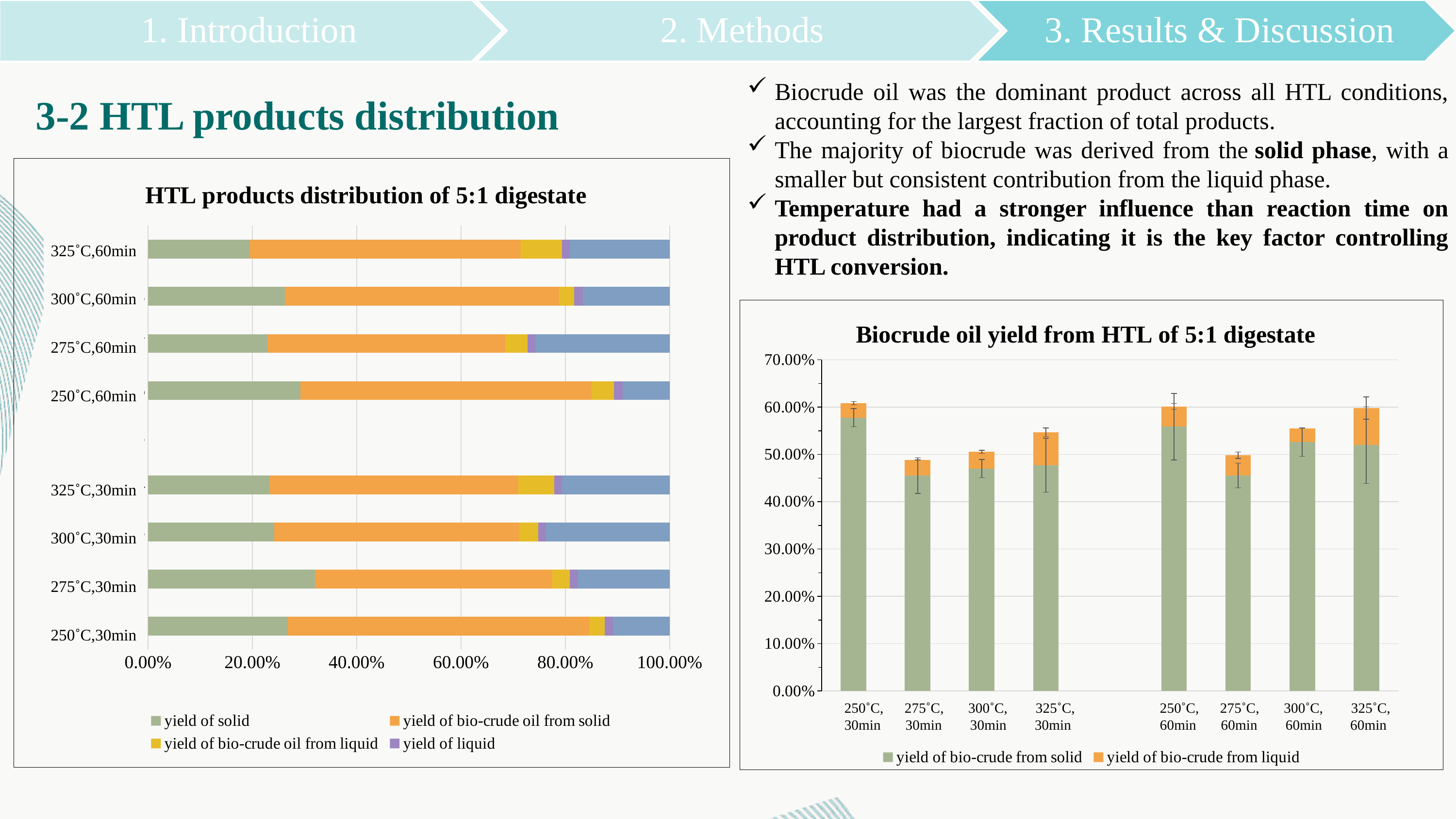
In the 'HTL products distribution of 5:1 digestate' chart, which series is shown in orange? yield of bio-crude oil from solid In the 'Biocrude oil yield from HTL of 5:1 digestate' chart, is the total biocrude yield for 325˚C, 30min greater or less than 50.00%? greater In the 'Biocrude oil yield from HTL of 5:1 digestate' chart, is the total biocrude yield for 275˚C, 30min greater or less than 50.00%? less How many condition categories are plotted in the 'Biocrude oil yield from HTL of 5:1 digestate' chart? 8 In the 'HTL products distribution of 5:1 digestate' chart, which has the larger yield of solid: 275˚C,30min or 325˚C,60min? 275˚C,30min How many condition categories are plotted in the 'HTL products distribution of 5:1 digestate' chart? 8 In the 'HTL products distribution of 5:1 digestate' chart, is the yield of solid for 250˚C,60min greater or less than 40.00%? less What kind of chart is the 'HTL products distribution of 5:1 digestate' chart on the left? Stacked bar chart What is the title of the chart on the right side of the slide? Biocrude oil yield from HTL of 5:1 digestate In the 'Biocrude oil yield from HTL of 5:1 digestate' chart, which has the larger total biocrude yield: 250˚C, 30min or 275˚C, 30min? 250˚C, 30min How many series does the legend of the 'Biocrude oil yield from HTL of 5:1 digestate' chart list? 2 How many series does the legend of the 'HTL products distribution of 5:1 digestate' chart list? 4